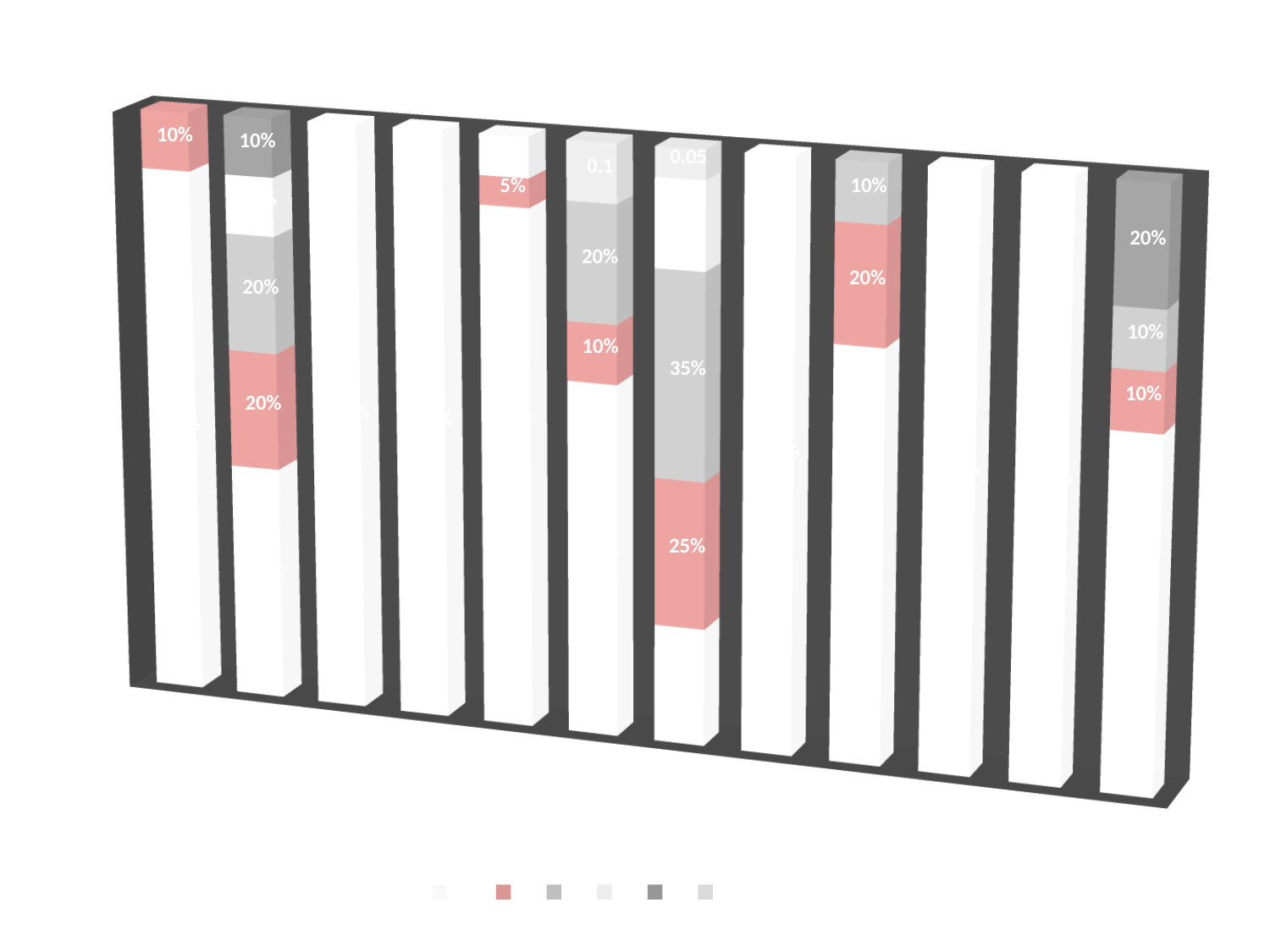
What is the value of the dark grey segment at the top of the rightmost bar? 20% What kind of chart is shown on the slide? bar chart How many bars does the chart contain? 12 Which is larger: the pink segment in the second bar from the left or the pink segment in the seventh bar from the left? the seventh bar (25%) What is the value of the pink segment in the seventh bar from the left? 25% How many colour swatches does the legend show? 6 What is the value of the grey segment in the seventh bar from the left? 35% What is the largest value printed on any segment in the chart? 35% What is the total of the three labelled segments in the rightmost bar (20%, 10%, 10%)? 40% What is the value of the pink segment in the leftmost bar? 10% What is the difference between the grey segment (35%) and the pink segment (25%) in the seventh bar from the left? 10% What is the value of the pink segment in the fifth bar from the left? 5%